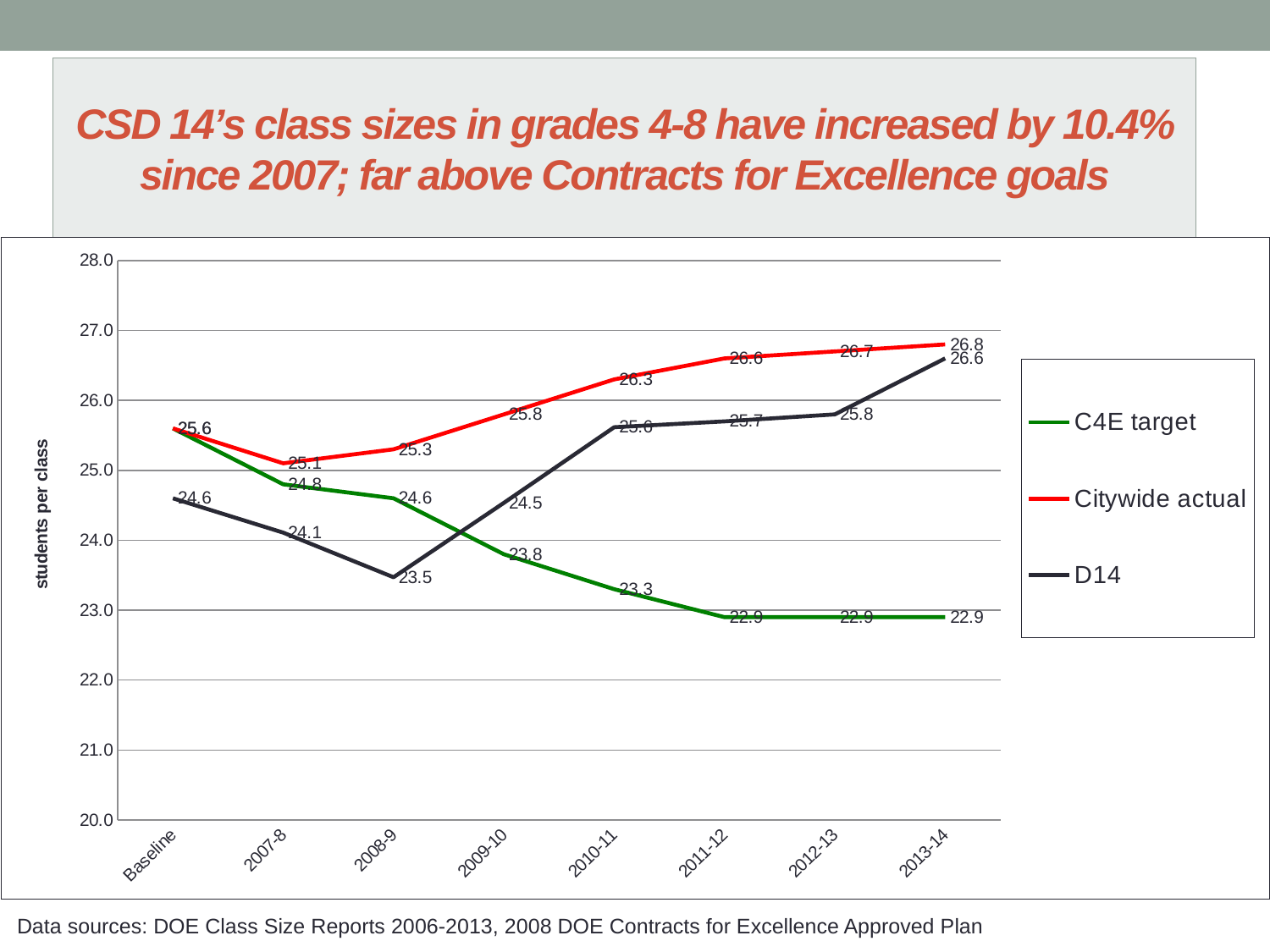
What is the C4E target value for 2009-10? 23.8 What is the difference between the Citywide actual and C4E target values in 2013-14? 3.9 How many series does the legend list? 3 In 2010-11, which is larger: the D14 value or the C4E target value? D14 In which year is the D14 value lowest? 2008-9 How many points are plotted along the x axis for each series? 8 What is the Citywide actual value for 2011-12? 26.6 What kind of chart is shown on the slide? line chart In which year is the Citywide actual value highest? 2013-14 What is the D14 value for 2013-14? 26.6 Does the C4E target series rise or fall from Baseline to 2013-14? fall What is the label on the vertical axis? students per class